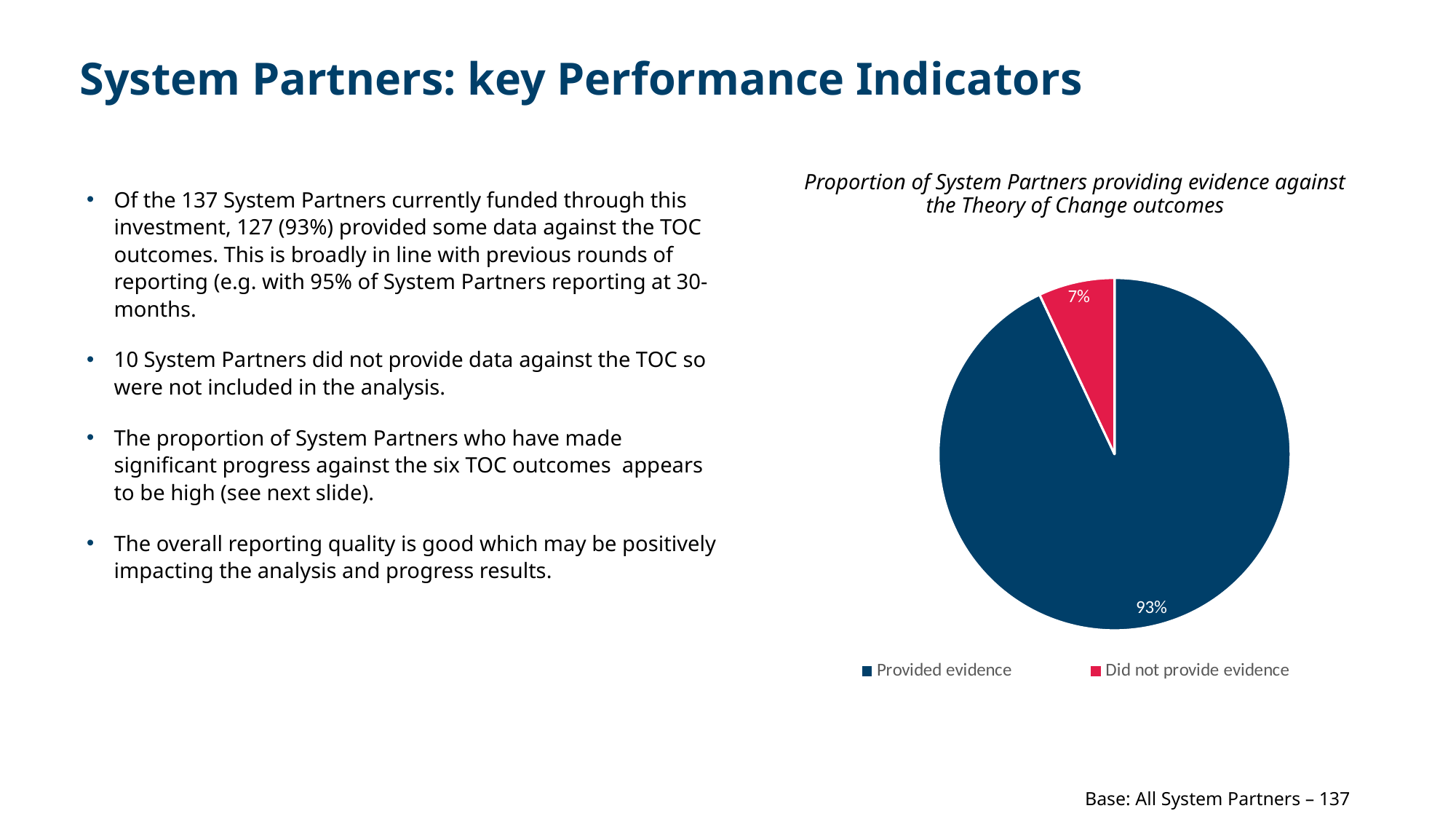
Which slice of the pie is the smallest? Did not provide evidence What percentage of System Partners did not provide evidence? 7% What is the difference in percentage points between the 'Provided evidence' and 'Did not provide evidence' slices? 86 What kind of chart is shown on the slide? Pie chart What is the title of the pie chart? Proportion of System Partners providing evidence against the Theory of Change outcomes Which is larger: the share that provided evidence or the share that did not provide evidence? Provided evidence How many slices does the pie chart have? 2 What colour is the 'Did not provide evidence' slice? Red Which slice of the pie is the largest? Provided evidence What share of the pie does the 'Did not provide evidence' slice represent? 7% What percentage of System Partners provided evidence? 93% How many entries does the legend list? 2